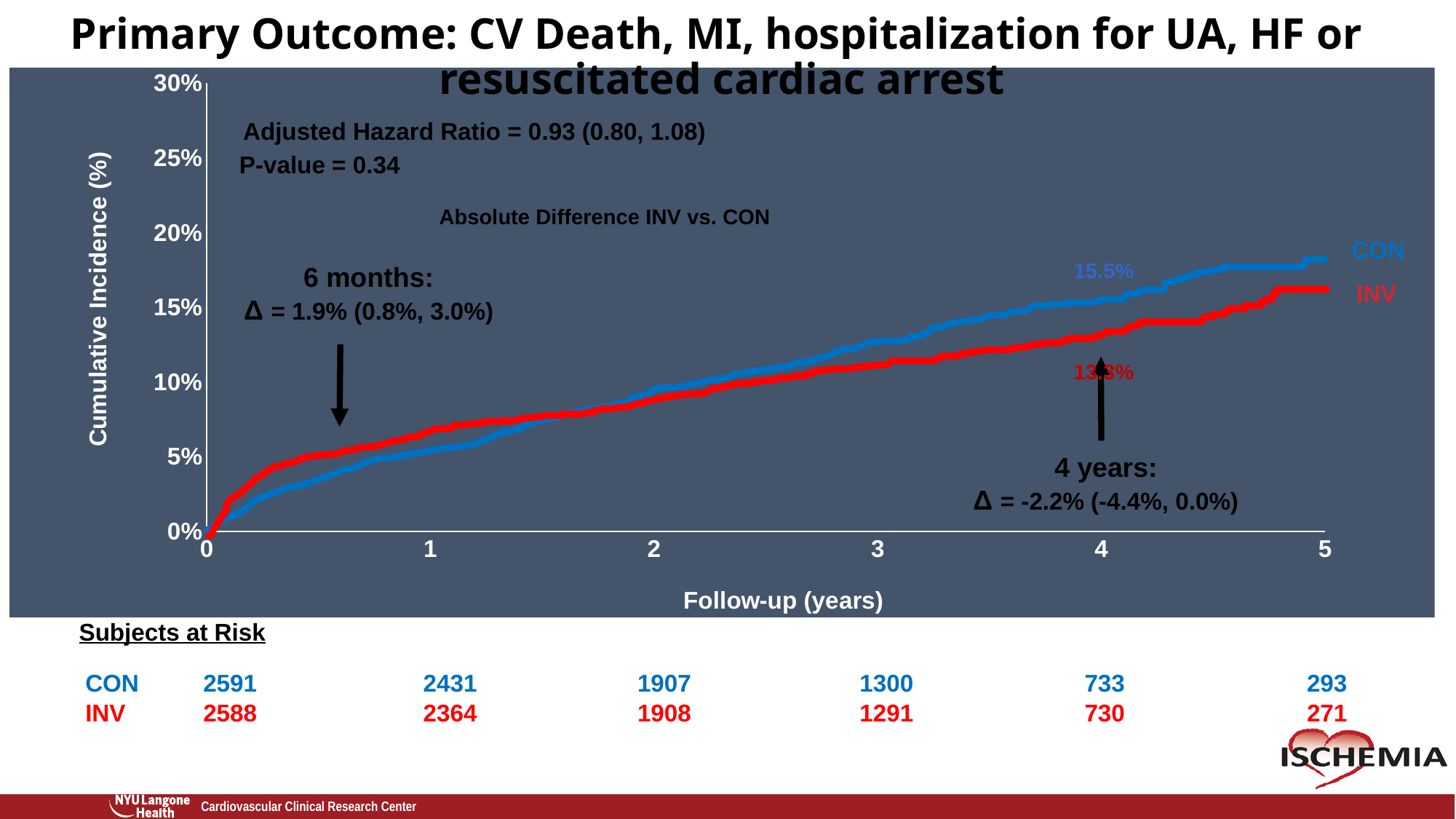
How many series (treatment groups) are plotted on the chart? 2 What is the absolute difference (Δ) INV vs. CON at 6 months, as annotated on the chart? 1.9% (0.8%, 3.0%) What is the cumulative incidence for CON at 4 years, as labelled on the chart? 15.5% What is the adjusted hazard ratio shown on the chart? 0.93 (0.80, 1.08) Is the cumulative incidence for CON at 5 years greater or less than 15%? greater What kind of chart is shown on the slide? Line chart In the Subjects at Risk table, how many CON subjects are at risk at year 0? 2591 What is the absolute difference (Δ) INV vs. CON at 4 years, as annotated on the chart? -2.2% (-4.4%, 0.0%) Is the cumulative incidence for INV at 1 year greater or less than 10%? less Do the cumulative incidence curves rise or fall as follow-up time increases? Rise At 6 months of follow-up, which group has the higher cumulative incidence, CON or INV? INV At 4 years of follow-up, which group has the higher cumulative incidence, CON or INV? CON